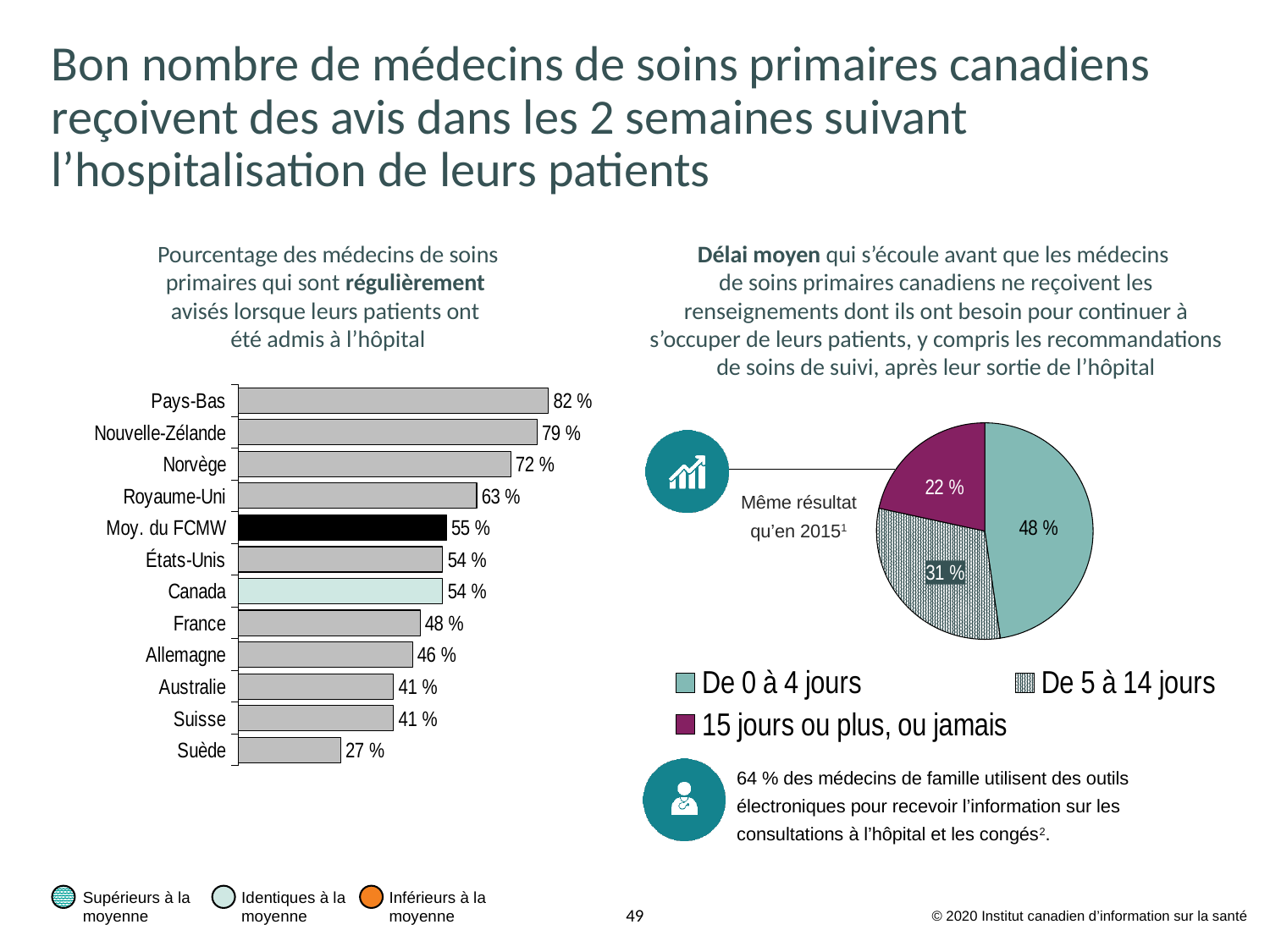
In the bar chart on the left, which country has the highest value? Pays-Bas In the bar chart on the left, which country has the lowest value? Suède In the bar chart on the left, what is the difference between the values for Pays-Bas and Suède? 55 % In the pie chart on the right, what is the value for '15 jours ou plus, ou jamais'? 22 % How many categories are shown in the bar chart on the left? 12 In the pie chart on the right, what share is shown for 'De 0 à 4 jours'? 48 % What kind of chart is the chart on the left of the slide? Bar chart In the pie chart on the right, which slice is the largest? De 0 à 4 jours In the bar chart on the left, what is the value for Canada? 54 % In the bar chart on the left, which is larger, the value for Royaume-Uni or the value for France? Royaume-Uni How many entries does the legend of the pie chart on the right list? 3 In the bar chart on the left, what is the value for Norvège? 72 %